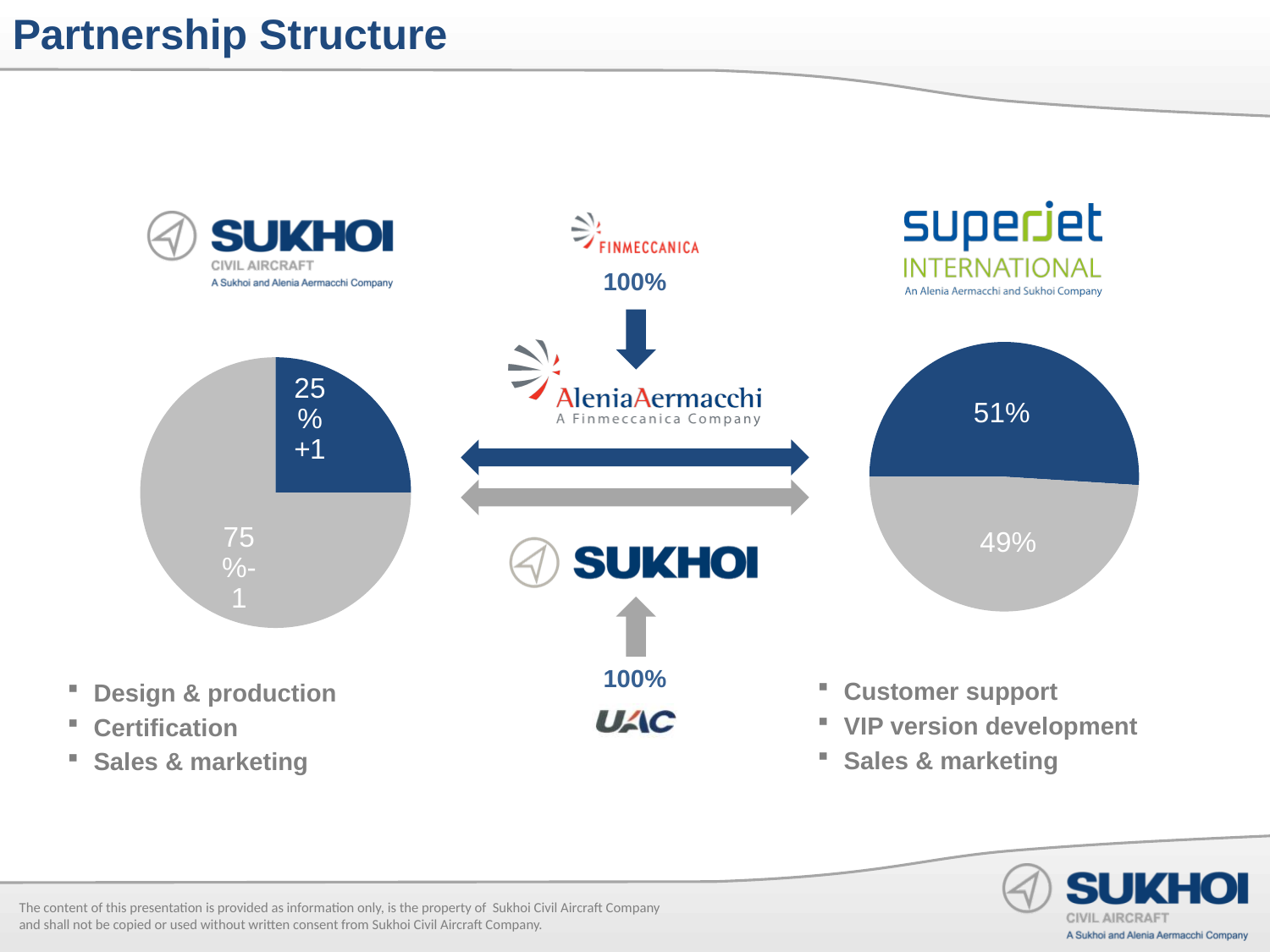
What kind of chart is shown on the left side of the slide, under the Sukhoi Civil Aircraft logo? Pie chart In the left pie chart (under the Sukhoi Civil Aircraft logo), what value is labelled on the blue slice? 25%+1 How many slices does the left pie chart (under the Sukhoi Civil Aircraft logo) have? 2 In the right pie chart (under the SuperJet International logo), what value is labelled on the blue slice? 51% In the right pie chart (under the SuperJet International logo), what value is labelled on the grey slice? 49% In the left pie chart (under the Sukhoi Civil Aircraft logo), what value is labelled on the grey slice? 75%-1 How many slices does the right pie chart (under the SuperJet International logo) have? 2 What kind of chart is shown on the right side of the slide, under the SuperJet International logo? Pie chart In the left pie chart (under the Sukhoi Civil Aircraft logo), which slice is larger, the blue one or the grey one? The grey one In the right pie chart (under the SuperJet International logo), which slice is larger, the blue one or the grey one? The blue one How many pie charts are shown on the slide? 2 In the right pie chart (under the SuperJet International logo), what is the difference between the blue slice's value and the grey slice's value? 2%